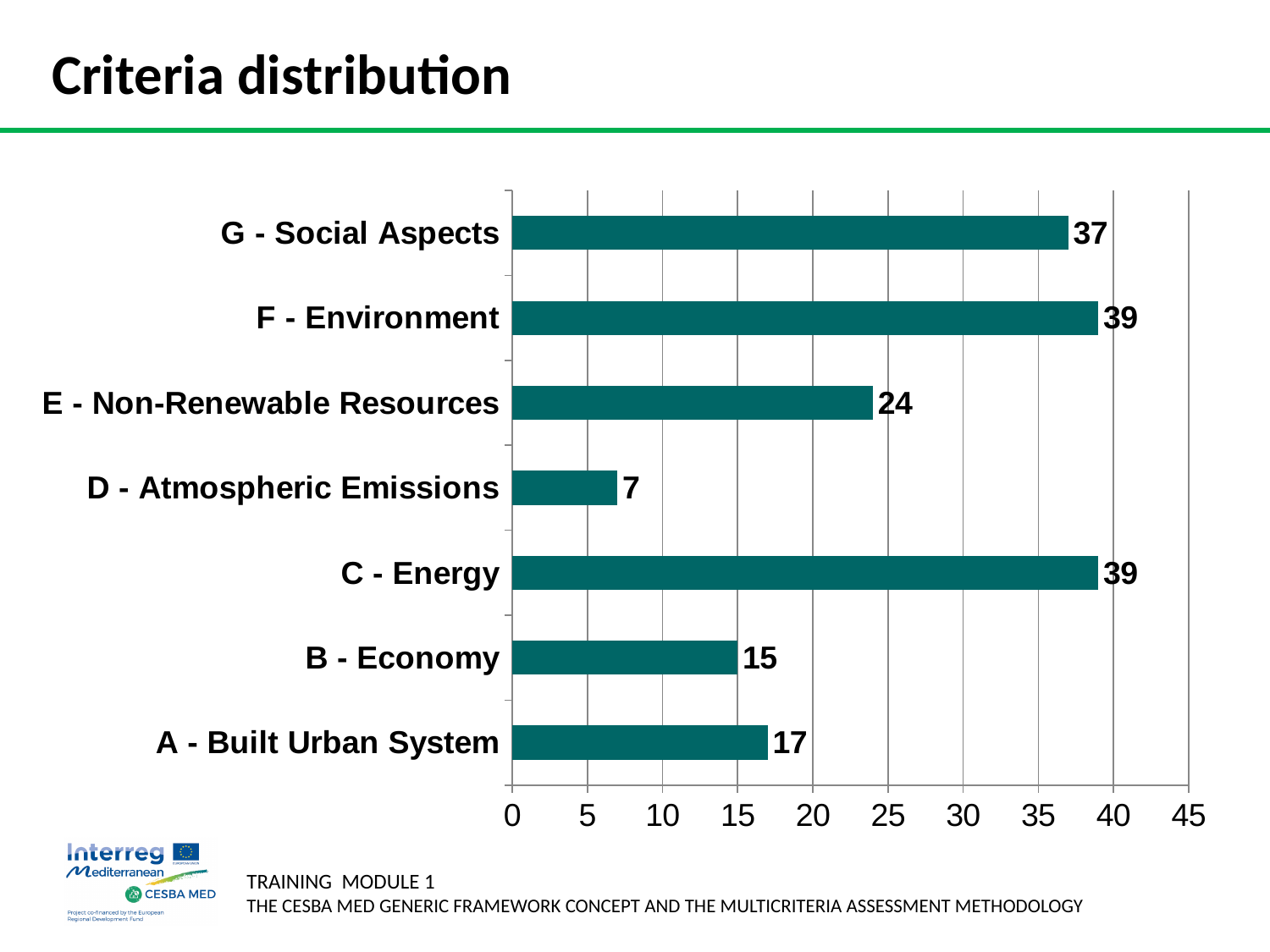
What is the value for D - Atmospheric Emissions? 7 Is the value for E - Non-Renewable Resources greater or less than 20? greater What is the value for G - Social Aspects? 37 What is the difference between the values for F - Environment and A - Built Urban System? 22 What is the highest value shown on the x axis? 45 What is the value for E - Non-Renewable Resources? 24 How many categories are shown in the chart? 7 Which is larger, the value for A - Built Urban System or the value for B - Economy? A - Built Urban System Which category has the lowest value? D - Atmospheric Emissions What kind of chart is shown on the slide? bar chart What is the value for B - Economy? 15 What is the title of the slide containing the chart? Criteria distribution